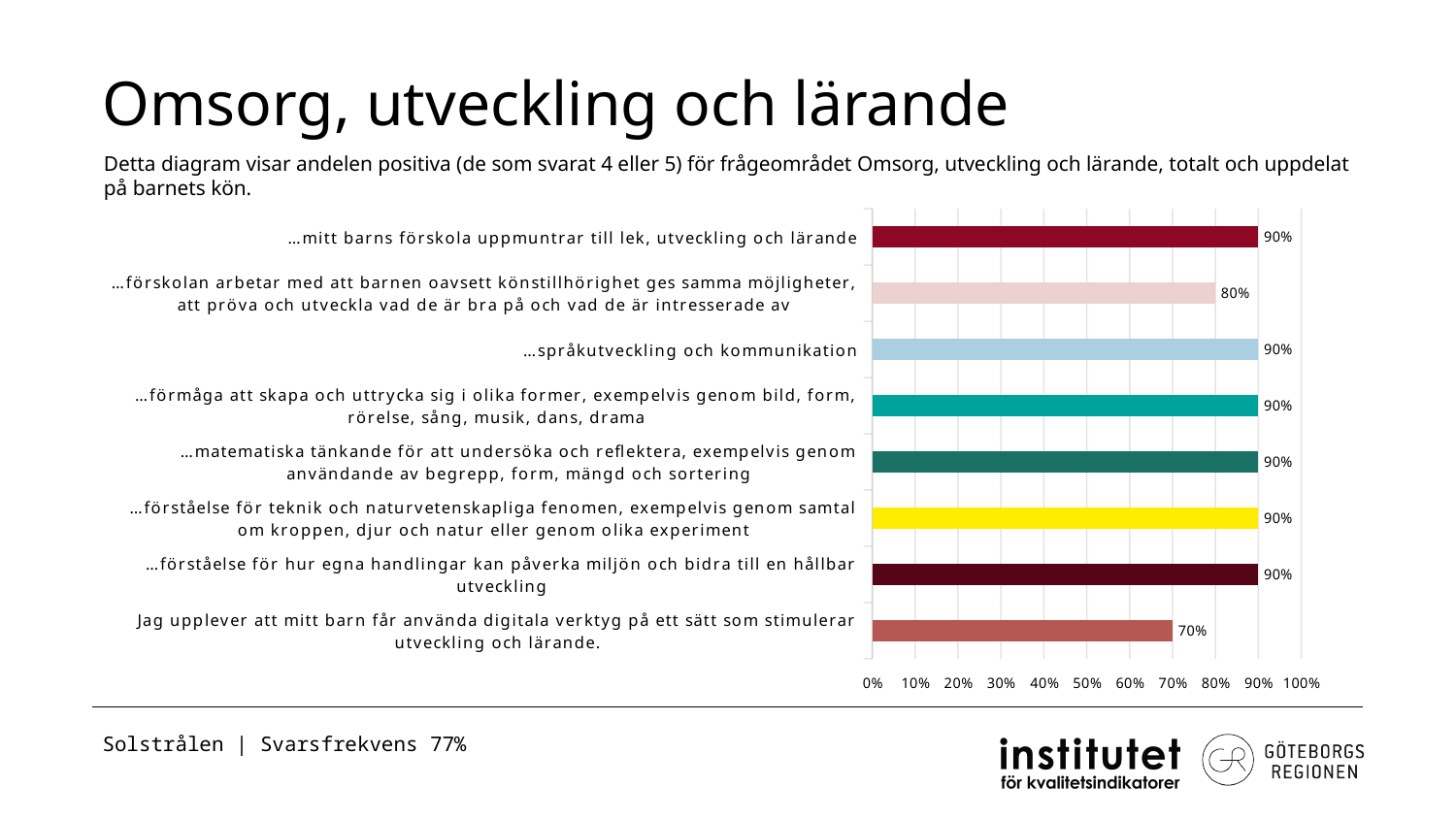
Which is larger: the value for "…förståelse för teknik och naturvetenskapliga fenomen, exempelvis genom samtal om kroppen, djur och natur eller genom olika experiment" or the value for "Jag upplever att mitt barn får använda digitala verktyg på ett sätt som stimulerar utveckling och lärande."? …förståelse för teknik och naturvetenskapliga fenomen, exempelvis genom samtal om kroppen, djur och natur eller genom olika experiment How many categories have a value of 90%? 6 What kind of chart is shown on the slide? bar chart What is the difference between the value for "…mitt barns förskola uppmuntrar till lek, utveckling och lärande" and the value for "Jag upplever att mitt barn får använda digitala verktyg på ett sätt som stimulerar utveckling och lärande."? 20% What is the value for "Jag upplever att mitt barn får använda digitala verktyg på ett sätt som stimulerar utveckling och lärande."? 70% What is the highest value shown on the x axis? 100% Which category has the lowest value? Jag upplever att mitt barn får använda digitala verktyg på ett sätt som stimulerar utveckling och lärande. What is the value for "…förskolan arbetar med att barnen oavsett könstillhörighet ges samma möjligheter, att pröva och utveckla vad de är bra på och vad de är intresserade av"? 80% What is the value for "…språkutveckling och kommunikation"? 90% What is the difference between the value for "…språkutveckling och kommunikation" and the value for "…förskolan arbetar med att barnen oavsett könstillhörighet ges samma möjligheter, att pröva och utveckla vad de är bra på och vad de är intresserade av"? 10% Is the value for "…förskolan arbetar med att barnen oavsett könstillhörighet ges samma möjligheter, att pröva och utveckla vad de är bra på och vad de är intresserade av" greater or less than 50%? greater How many categories are shown in the chart? 8